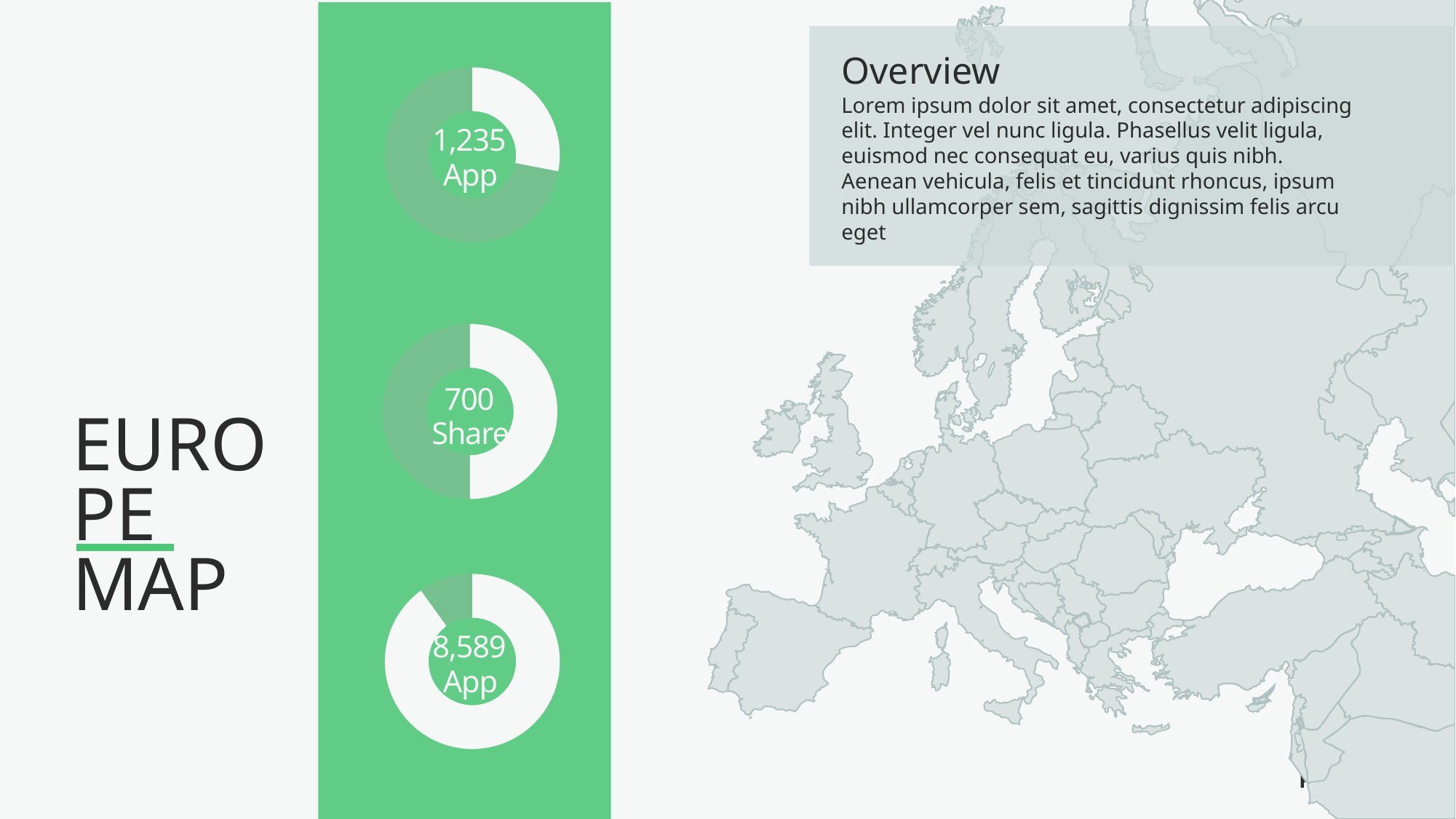
What is the difference between the centre values of the bottom and top donut charts? 7,354 How many donut charts are shown in the green panel? 3 In the top donut chart, which portion is larger: the white segment or the dark green segment? The dark green segment Which donut chart shows the smallest centre value? The middle chart (700 Share) What number is printed in the centre of the middle donut chart? 700 What label accompanies the number in the middle donut chart? Share What number is printed in the centre of the top donut chart? 1,235 What is the title of the text box at the top right of the slide? Overview What kind of charts are shown in the green panel on the left of the slide? Donut (pie) charts Which donut chart shows the largest centre value? The bottom chart (8,589 App) What number is printed in the centre of the bottom donut chart? 8,589 Which donut chart has the largest white (filled) segment? The bottom chart (8,589 App)